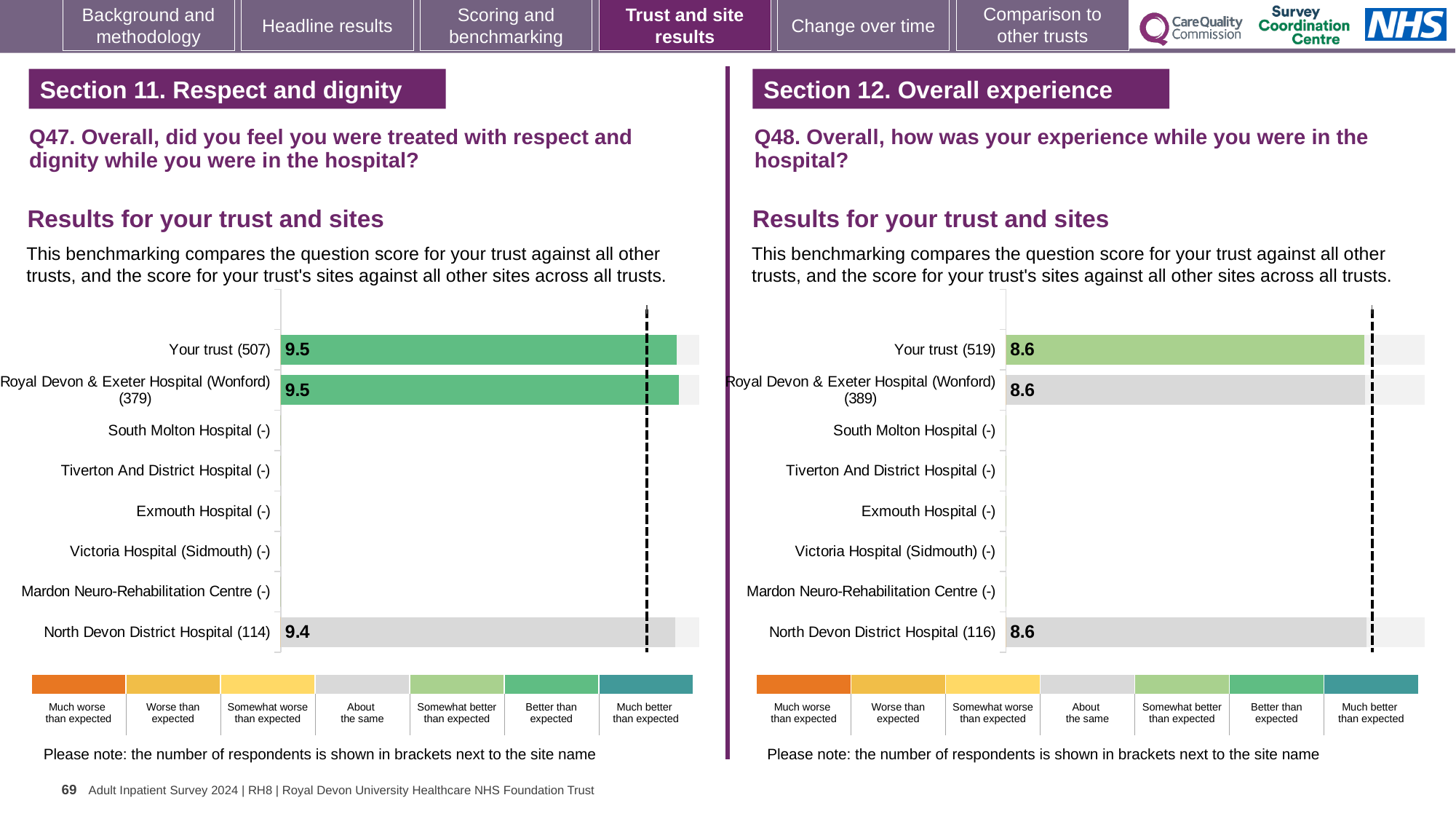
On the Q48 chart (right), what is the score for Your trust (519)? 8.6 On the Q47 chart (left), what is the score for Your trust (507)? 9.5 On the Q47 chart (left), which benchmark category does the colour of the Your trust (507) bar correspond to in the legend? Better than expected On the Q48 chart (right), how many rows have a bar with a score plotted? 3 On the Q48 chart (right), what is the score for North Devon District Hospital (116)? 8.6 What type of chart is used on the Q48 chart (right)? Bar chart On the Q47 chart (left), what is the score for North Devon District Hospital (114)? 9.4 On the Q47 chart (left), how many site or trust rows are listed on the vertical axis? 8 On the Q48 chart (right), which benchmark category does the colour of the Your trust (519) bar correspond to in the legend? Somewhat better than expected On the Q47 chart (left), which has the lower score: Your trust (507) or North Devon District Hospital (114)? North Devon District Hospital (114) On the Q47 chart (left), what is the score for Royal Devon & Exeter Hospital (Wonford) (379)? 9.5 On the Q47 chart (left), what is the difference between the score for Your trust (507) and the score for North Devon District Hospital (114)? 0.1